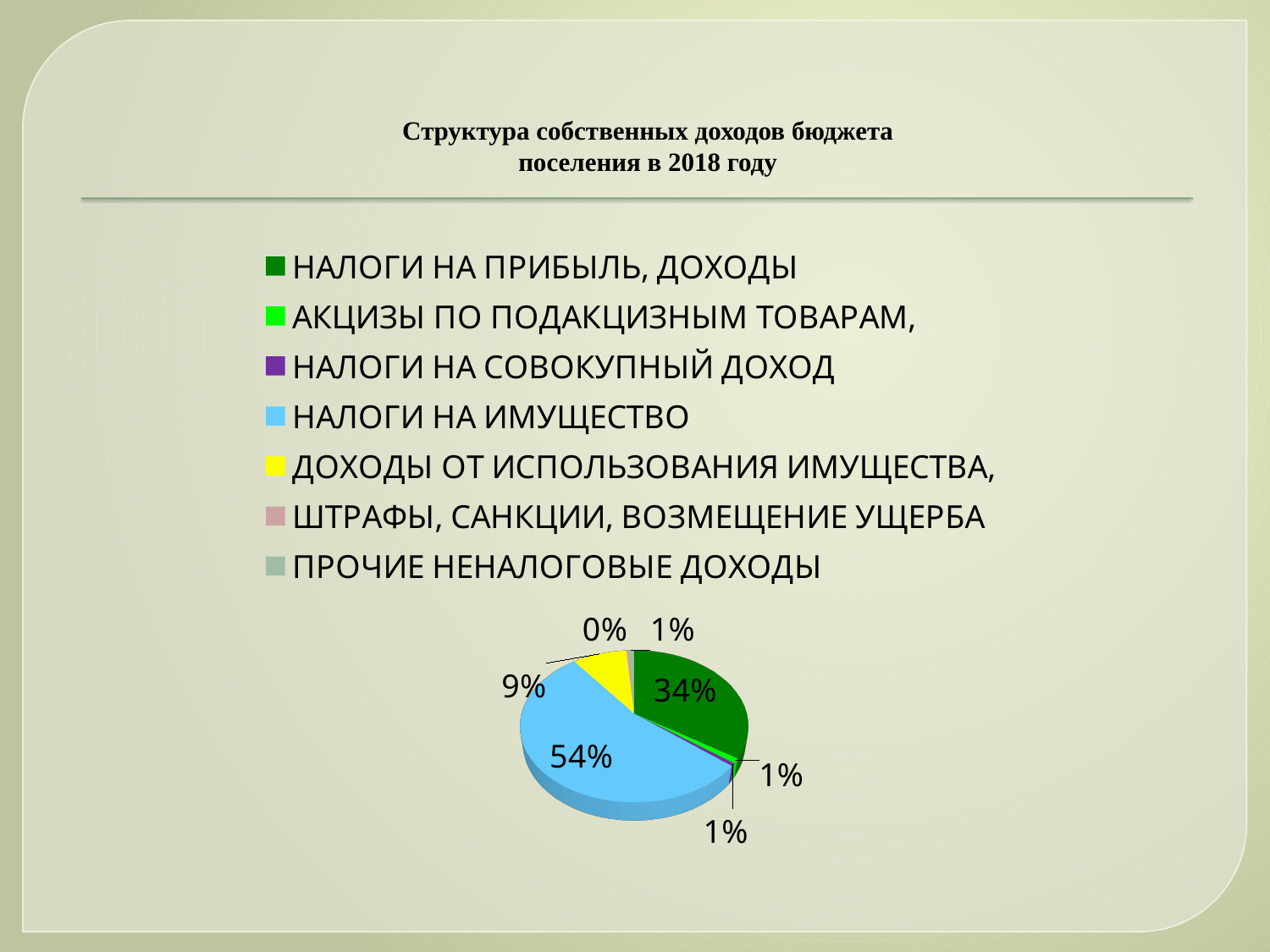
What share of the pie does ШТРАФЫ, САНКЦИИ, ВОЗМЕЩЕНИЕ УЩЕРБА have? 0% What is the difference in percentage points between the shares of НАЛОГИ НА ИМУЩЕСТВО and НАЛОГИ НА ПРИБЫЛЬ, ДОХОДЫ? 20 What share of the pie does ДОХОДЫ ОТ ИСПОЛЬЗОВАНИЯ ИМУЩЕСТВА have? 9% What is the title of the slide? Структура собственных доходов бюджета поселения в 2018 году Which has a larger share: НАЛОГИ НА ПРИБЫЛЬ, ДОХОДЫ or ДОХОДЫ ОТ ИСПОЛЬЗОВАНИЯ ИМУЩЕСТВА? НАЛОГИ НА ПРИБЫЛЬ, ДОХОДЫ What colour is the slice for НАЛОГИ НА ИМУЩЕСТВО? light blue Which category has the largest share of the pie? НАЛОГИ НА ИМУЩЕСТВО What share of the pie does НАЛОГИ НА ПРИБЫЛЬ, ДОХОДЫ have? 34% What kind of chart is shown on the slide? pie chart Which category has the smallest share of the pie? ШТРАФЫ, САНКЦИИ, ВОЗМЕЩЕНИЕ УЩЕРБА What share of the pie does НАЛОГИ НА ИМУЩЕСТВО have? 54% How many categories does the legend list? 7